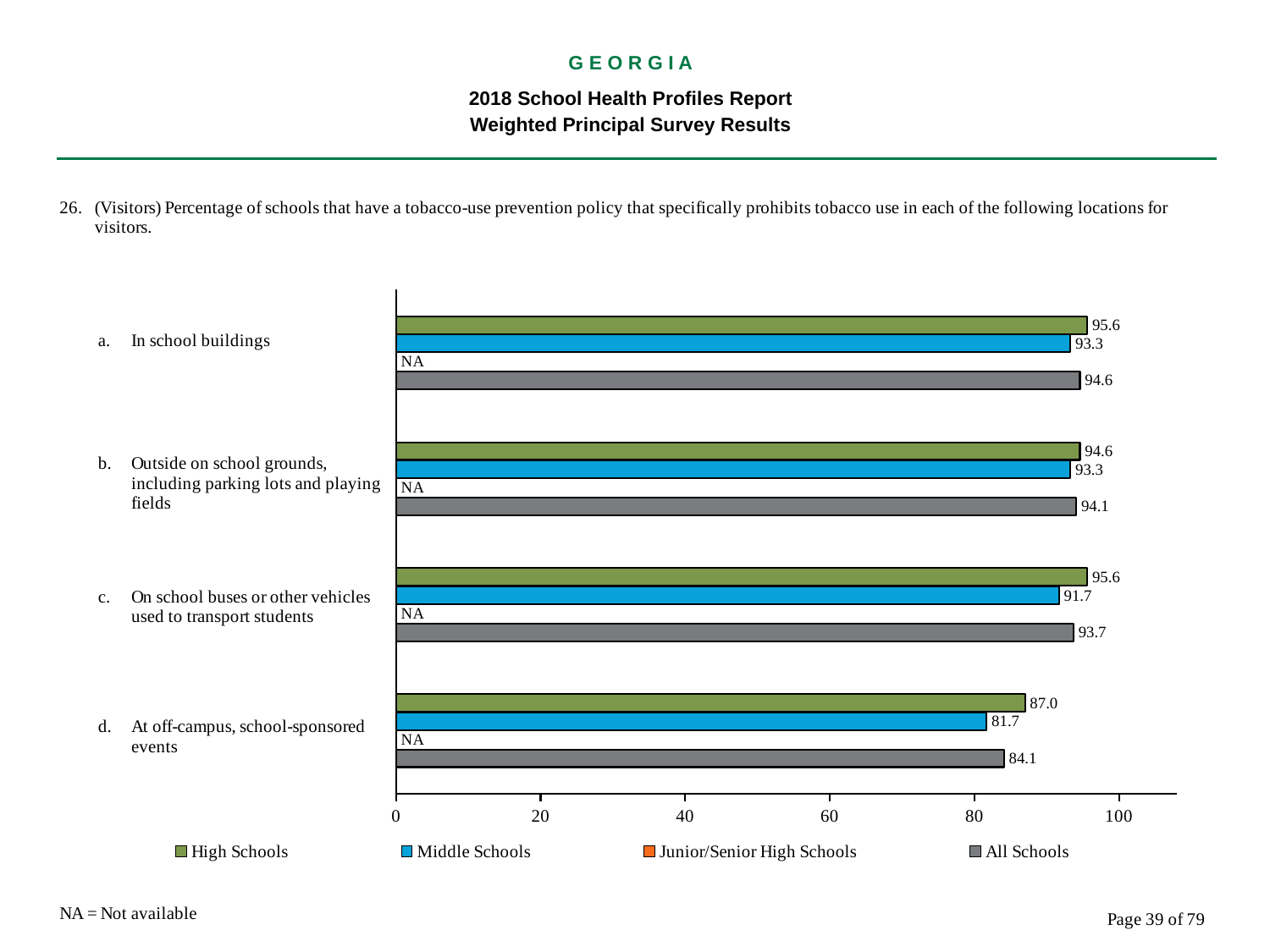
What is the difference between the High Schools and Middle Schools values for 'At off-campus, school-sponsored events'? 5.3 What is the value for All Schools for 'At off-campus, school-sponsored events'? 84.1 How many series does the legend list? 4 What is the value for High Schools for 'In school buildings'? 95.6 Which location has the lowest value for Middle Schools? At off-campus, school-sponsored events What is the value for Middle Schools for 'On school buses or other vehicles used to transport students'? 91.7 What kind of chart is shown on the slide? Bar chart Which location has the highest value for All Schools? In school buildings How many locations (categories) are shown on the chart? 4 Is the Middle Schools value for 'At off-campus, school-sponsored events' greater or less than 80? greater What is the value for Junior/Senior High Schools for 'Outside on school grounds, including parking lots and playing fields'? NA Which is larger for 'On school buses or other vehicles used to transport students': the High Schools value or the All Schools value? High Schools